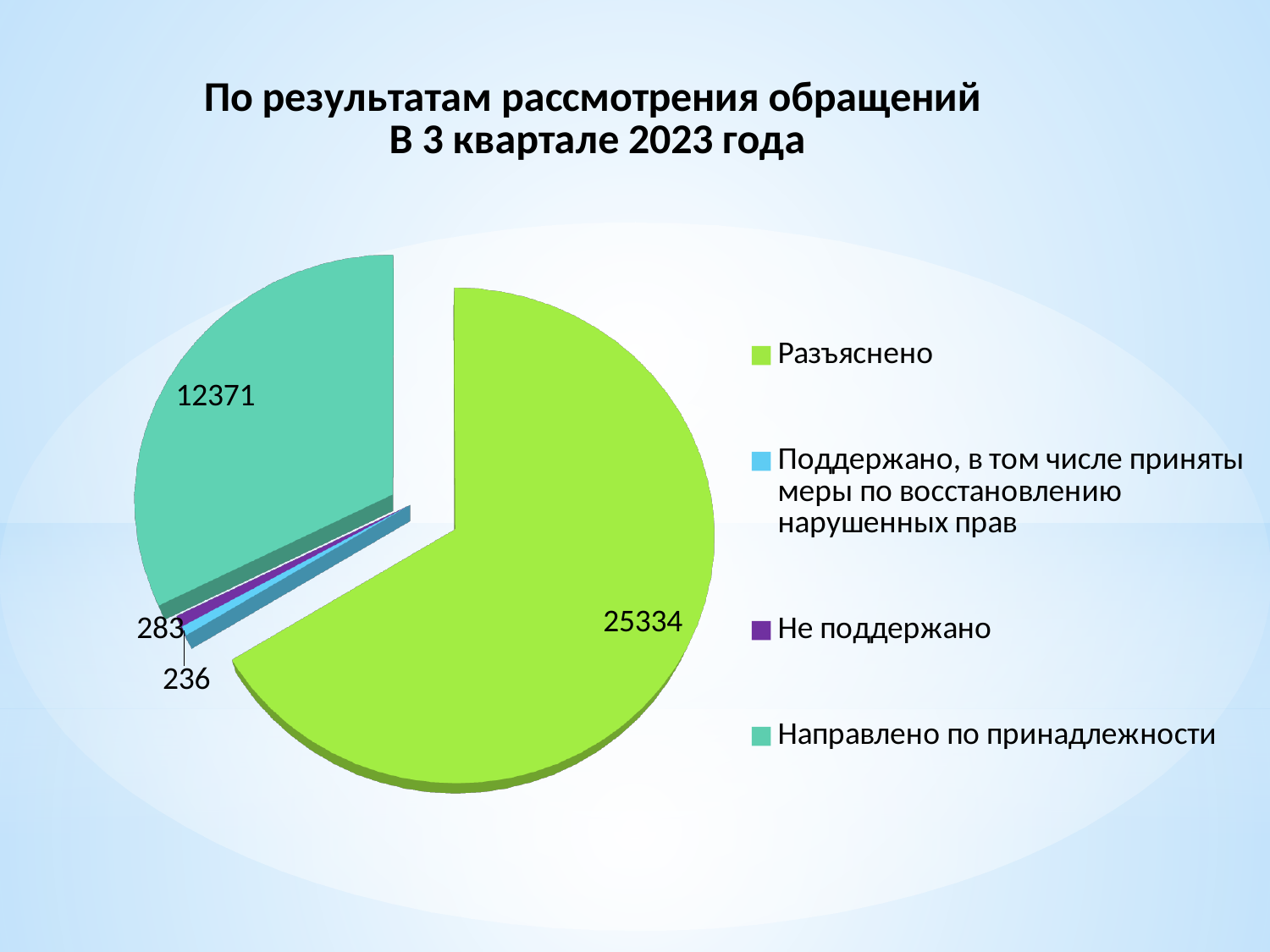
What is the difference between the values for Разъяснено and Направлено по принадлежности? 12963 Which is larger, the value for Разъяснено or the value for Направлено по принадлежности? Разъяснено What type of chart is shown on the slide? pie chart Which category has the largest slice of the pie? Разъяснено What colour is the slice for Направлено по принадлежности? teal What is the value for Разъяснено? 25334 What is the value for Не поддержано? 283 Which category has the smallest slice of the pie? Поддержано, в том числе приняты меры по восстановлению нарушенных прав How many categories does the legend list? 4 What is the value for Направлено по принадлежности? 12371 What is the value for Поддержано, в том числе приняты меры по восстановлению нарушенных прав? 236 What is the title of the chart? По результатам рассмотрения обращений В 3 квартале 2023 года